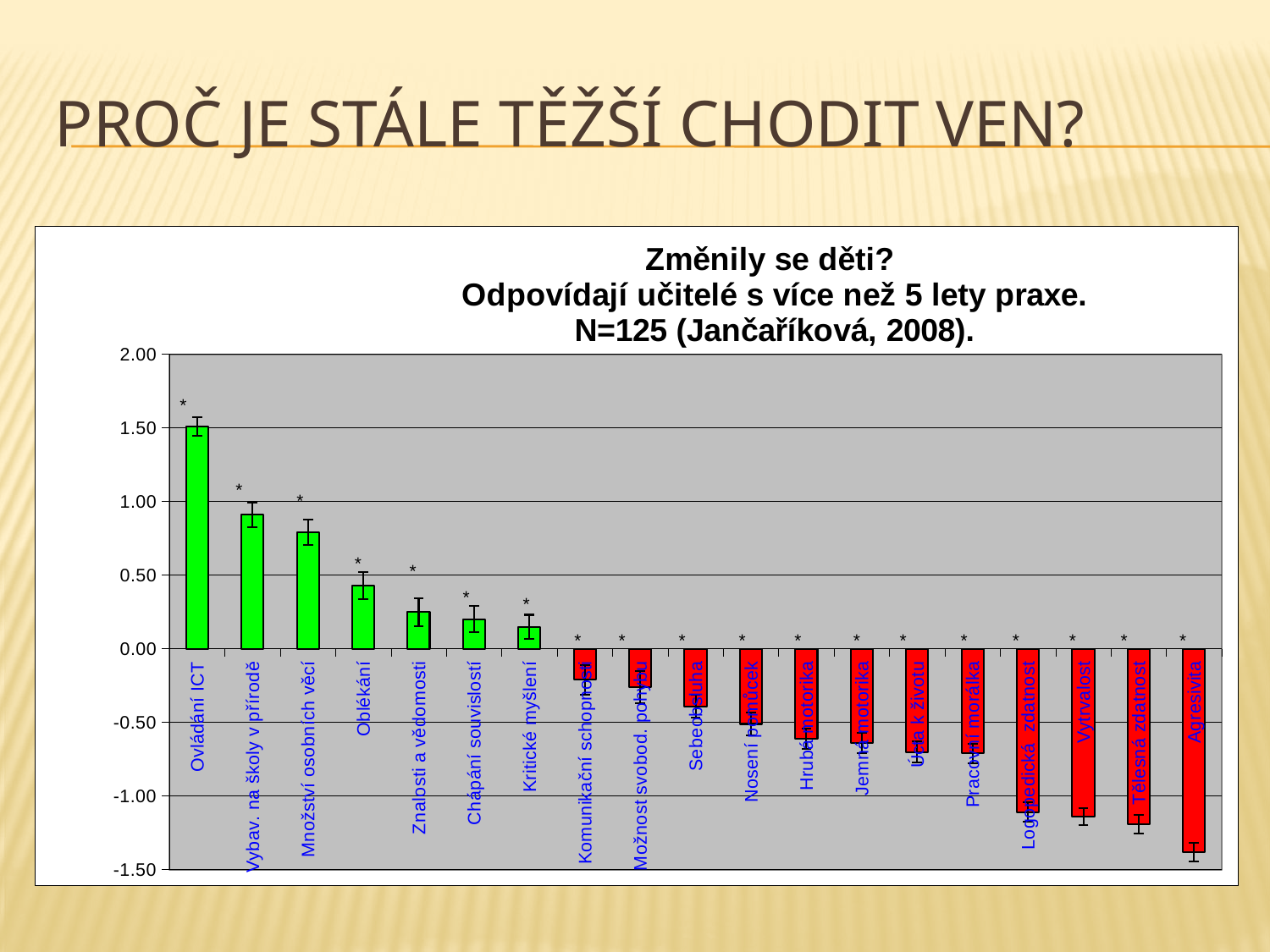
Which is larger, the value for Ovládání ICT or the value for Oblékání? Ovládání ICT Is the value for Ovládání ICT greater or less than 1.00? greater Do the values rise or fall from left to right along the x axis? fall Is the value for Hrubá motorika greater or less than -0.50? less Is the value for Kritické myšlení greater or less than 0.50? less What colour are the bars with negative values? red Which category has the highest value? Ovládání ICT How many categories are plotted in the chart? 19 Which category has the lowest value? Agresivita What kind of chart is shown on the slide? bar chart